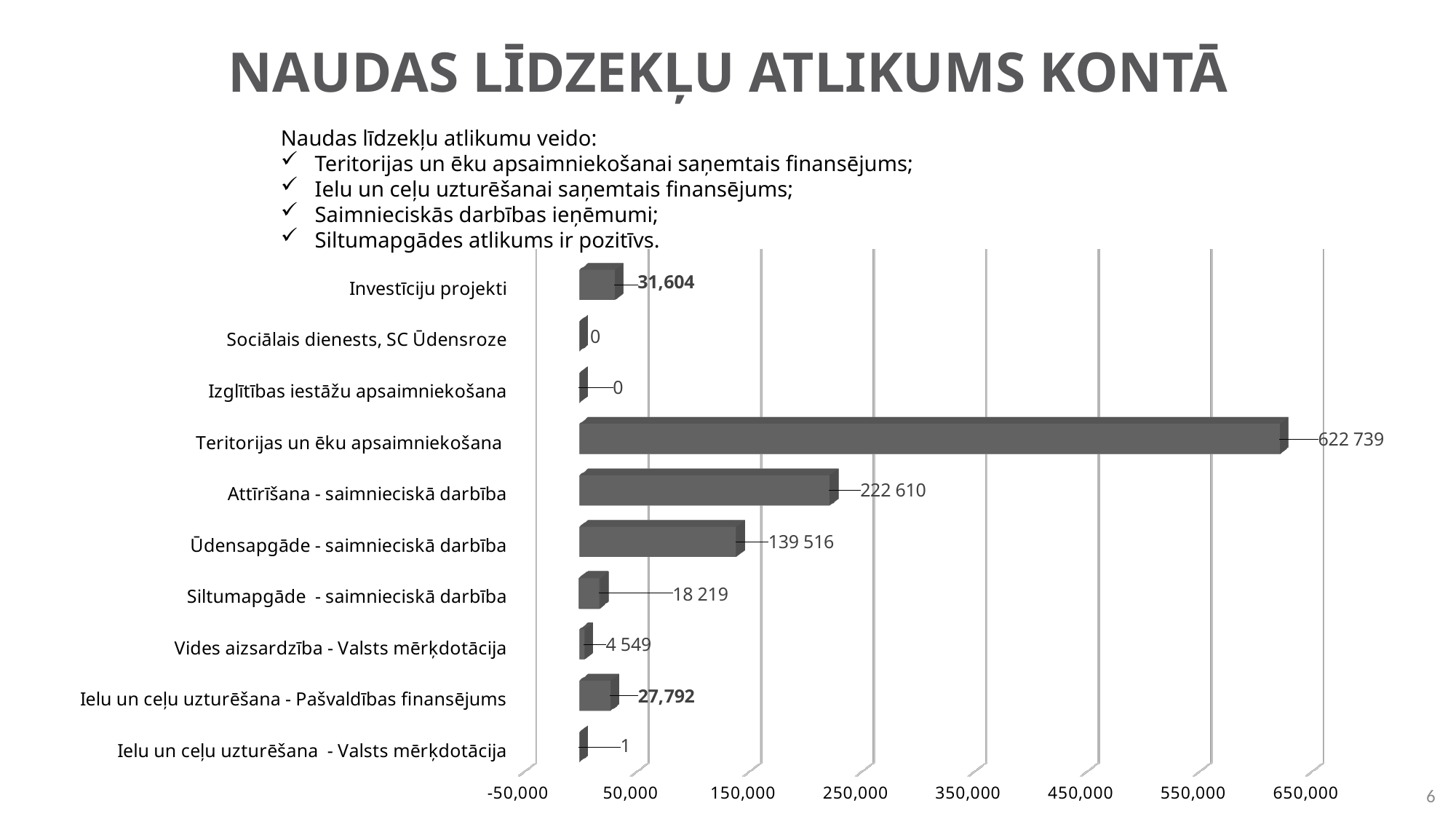
How many categories are shown in the chart? 10 What is the difference between Attīrīšana - saimnieciskā darbība and Ūdensapgāde - saimnieciskā darbība? 83 094 What is the title of the slide? NAUDAS LĪDZEKĻU ATLIKUMS KONTĀ What kind of chart is shown on the slide? bar chart Is the value for Attīrīšana - saimnieciskā darbība greater or less than 150,000? greater What is the value for Investīciju projekti? 31,604 What is the value for Ūdensapgāde - saimnieciskā darbība? 139 516 Which is larger: Siltumapgāde - saimnieciskā darbība or Ielu un ceļu uzturēšana - Pašvaldības finansējums? Ielu un ceļu uzturēšana - Pašvaldības finansējums What is the value for Teritorijas un ēku apsaimniekošana? 622 739 Which category has the highest value? Teritorijas un ēku apsaimniekošana What is the value for Ielu un ceļu uzturēšana - Valsts mērķdotācija? 1 How many categories have a value of 0? 2